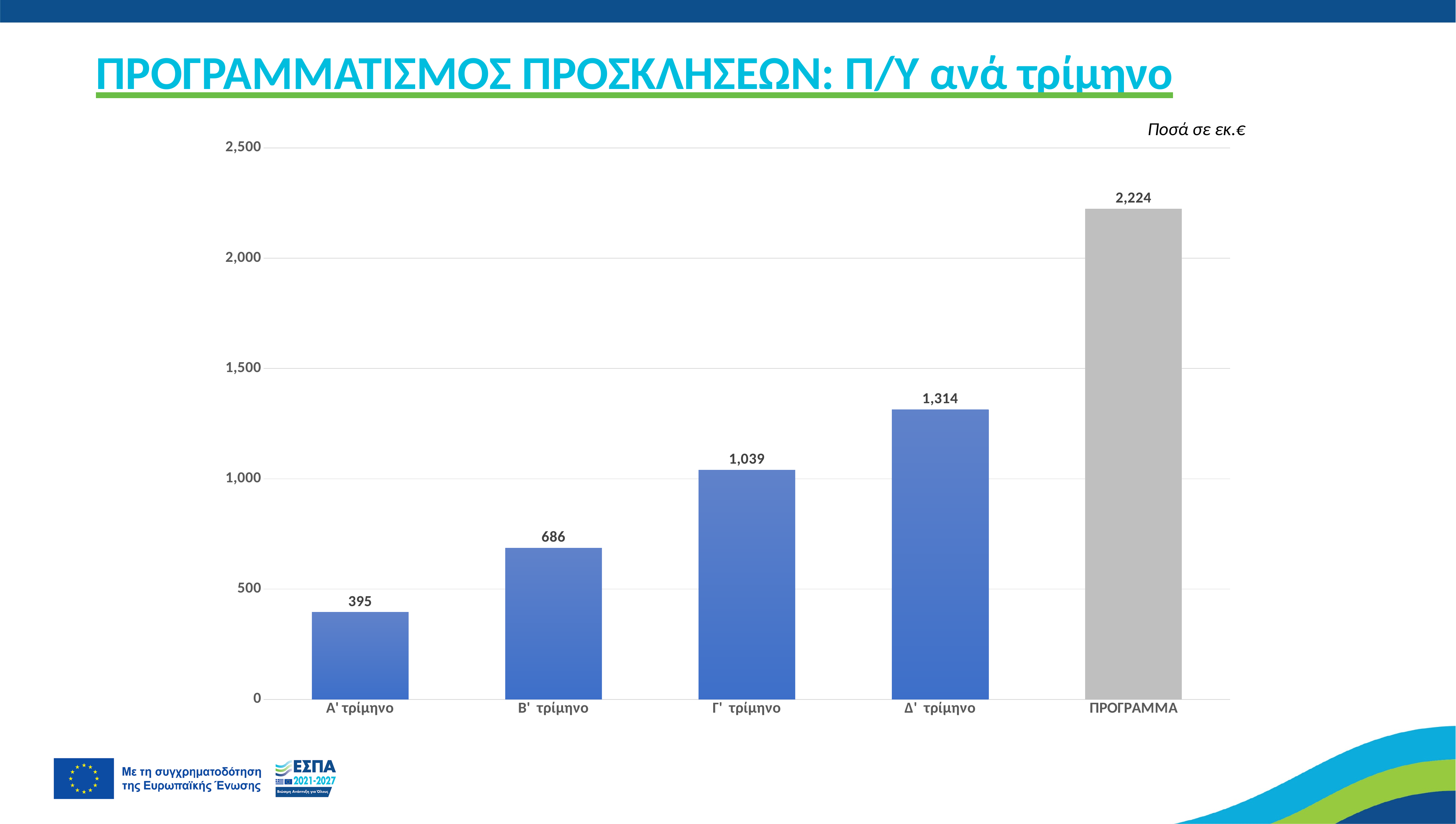
Which category has the lowest value? Α' τρίμηνο Which category has the highest value? ΠΡΟΓΡΑΜΜΑ What is the value for ΠΡΟΓΡΑΜΜΑ? 2,224 Which is larger, the value for Β' τρίμηνο or the value for Γ' τρίμηνο? Γ' τρίμηνο What is the value for Β' τρίμηνο? 686 How many categories are shown on the x axis? 5 Do the values rise or fall from Α' τρίμηνο to Δ' τρίμηνο? rise What is the value for Γ' τρίμηνο? 1,039 What is the difference between the values for Δ' τρίμηνο and Γ' τρίμηνο? 275 What is the value for Δ' τρίμηνο? 1,314 What is the value for Α' τρίμηνο? 395 What kind of chart is shown on the slide? bar chart